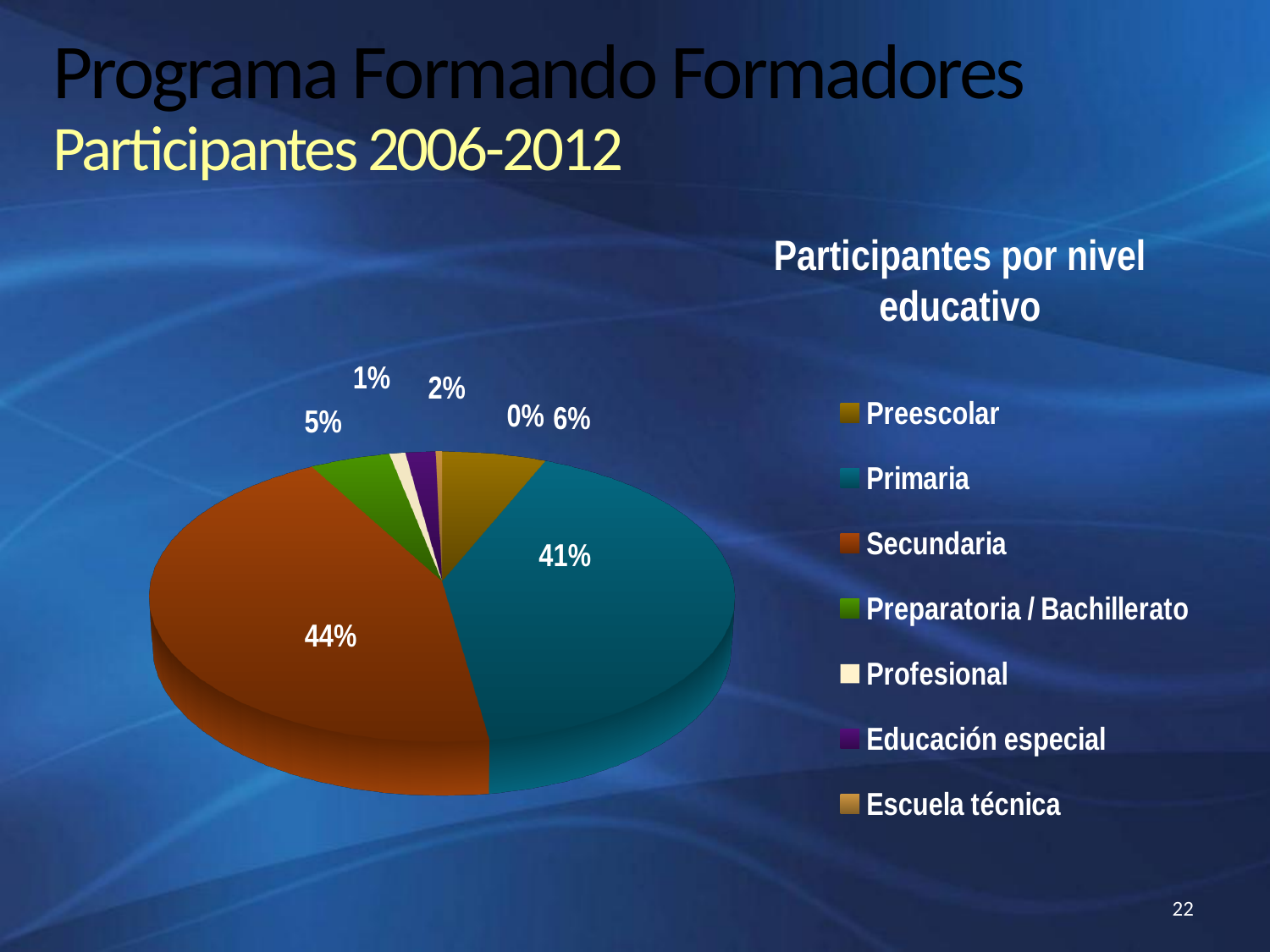
What is the title of the chart? Participantes por nivel educativo What share of participants is Primaria? 41% What share of participants is Escuela técnica? 0% Which educational level has the largest share of participants? Secundaria What share of participants is Preparatoria / Bachillerato? 5% How many categories does the legend list? 7 What share of participants is Secundaria? 44% Which has a larger share, Preescolar or Educación especial? Preescolar What is the difference in percentage points between Secundaria and Primaria? 3 What kind of chart is shown on the slide? pie chart Which educational level has the smallest share of participants? Escuela técnica What share of participants is Preescolar? 6%